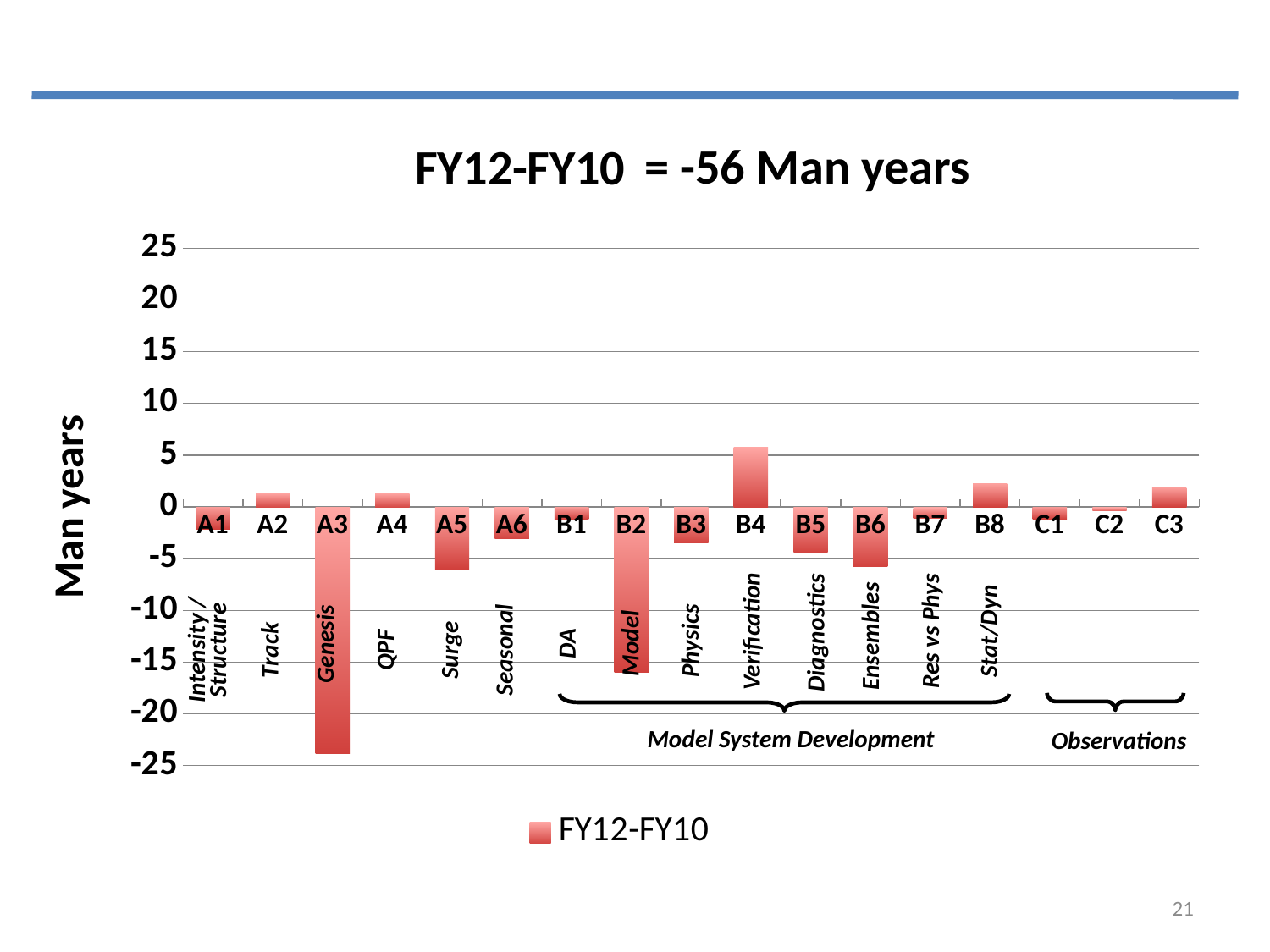
How many categories are plotted on the x axis? 17 Which category has the lowest (most negative) value? A3 What is the label of the series in the legend? FY12-FY10 Is the value for A3 greater or less than -20? less Is the value for B4 greater or less than 5? greater How many series does the legend list? 1 Which has the larger value, A5 or B4? B4 What is the title of the chart? FY12-FY10 = -56 Man years Is the value for B2 greater or less than -15? less What kind of chart is shown on the slide? bar chart Which has the lower value, A3 or B2? A3 Which category has the highest value? B4